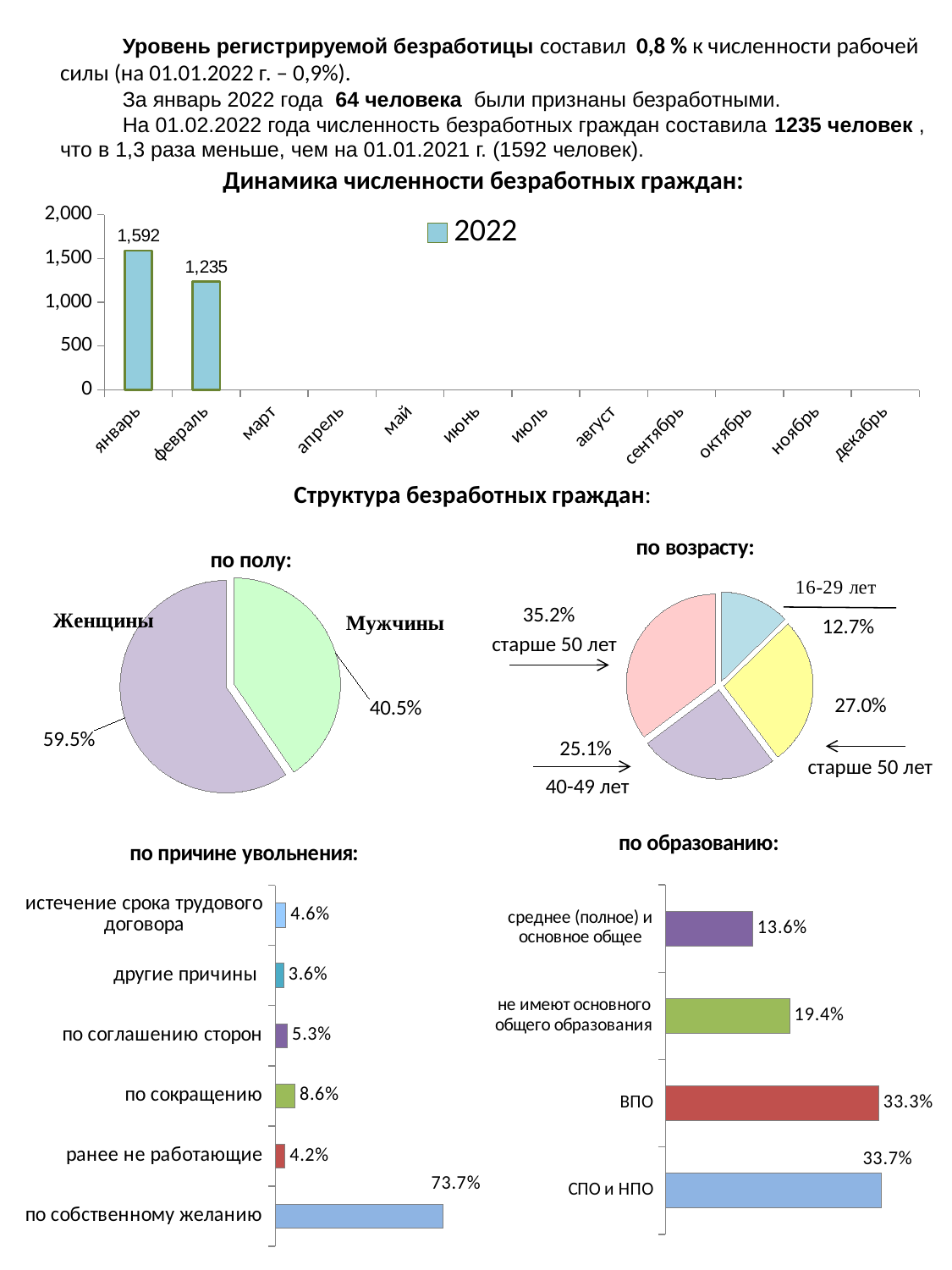
In the pie chart 'по полу', what share is Женщины? 59.5% In the chart 'по образованию', what is the value for ВПО? 33.3% In the chart 'по причине увольнения', what is the value for по сокращению? 8.6% In the chart 'Динамика численности безработных граждан', what is the value for январь? 1,592 In the pie chart 'по возрасту', what share is 16-29 лет? 12.7% In the chart 'Динамика численности безработных граждан', what is the value for февраль? 1,235 In the chart 'по причине увольнения', which category has the highest value? по собственному желанию In the pie chart 'по полу', which slice is larger, Женщины or Мужчины? Женщины In the pie chart 'по возрасту', what share is 40-49 лет? 25.1% In the chart 'Динамика численности безработных граждан', what series does the legend list? 2022 In the chart 'по причине увольнения', which category has the lowest value? другие причины In the chart 'Динамика численности безработных граждан', what is the difference between the январь and февраль values? 357